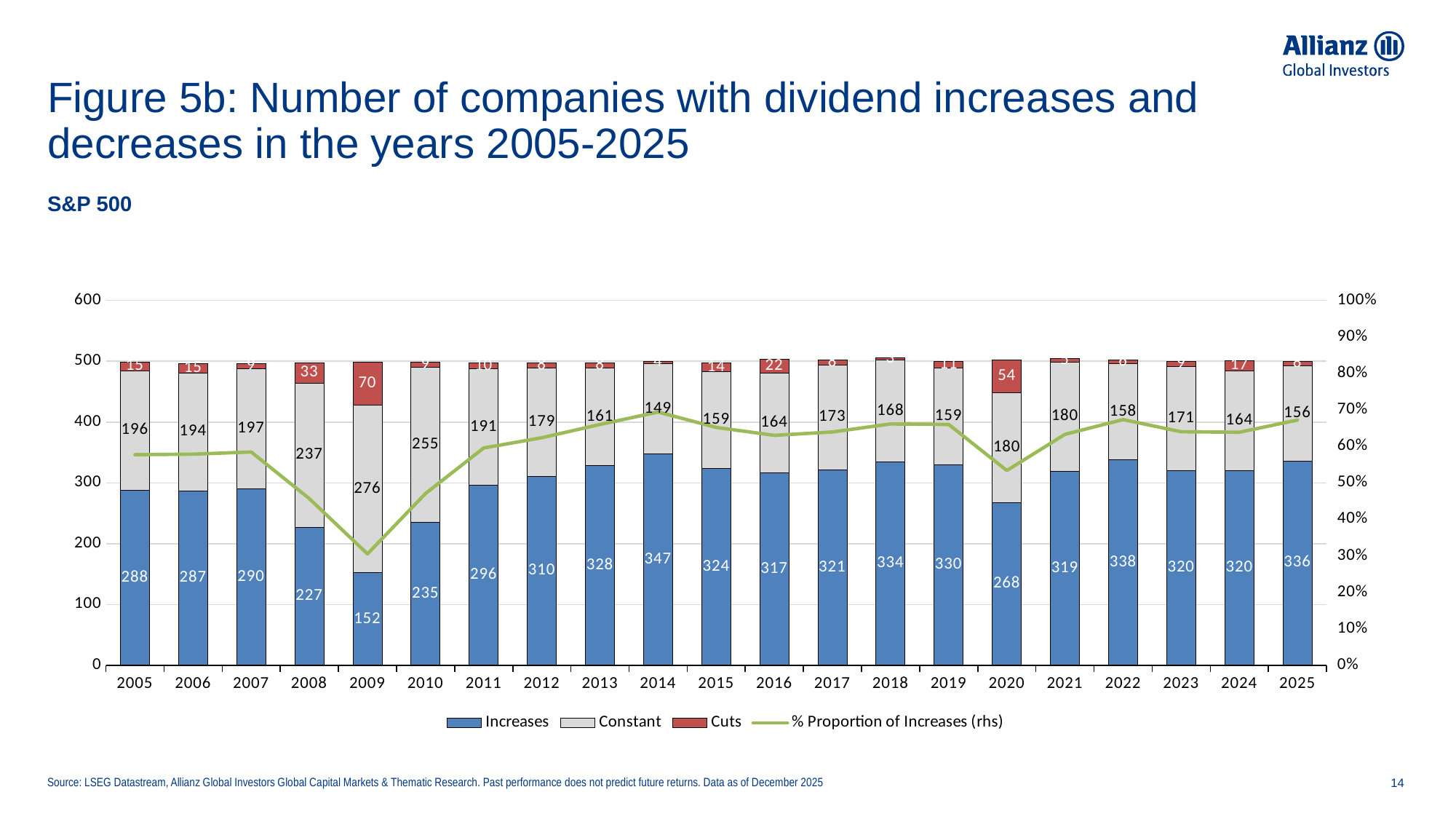
In which year was the number of dividend cuts highest? 2009 How many companies cut their dividend in 2020? 54 Do the number of dividend increases rise or fall from 2009 to 2014? rise Which year had more companies with dividend increases, 2021 or 2022? 2022 How many companies had dividend increases in 2014? 347 Is the % Proportion of Increases for 2009 greater or less than 40%? less In which year was the number of companies with dividend increases lowest? 2009 In which year was the number of companies with dividend increases highest? 2014 How many series does the legend list? 4 What is the total height of the stacked bar for 2009 (Increases + Constant + Cuts)? 498 What is the value of the Constant series for 2009? 276 What is the difference between the number of dividend increases in 2014 and in 2009? 195